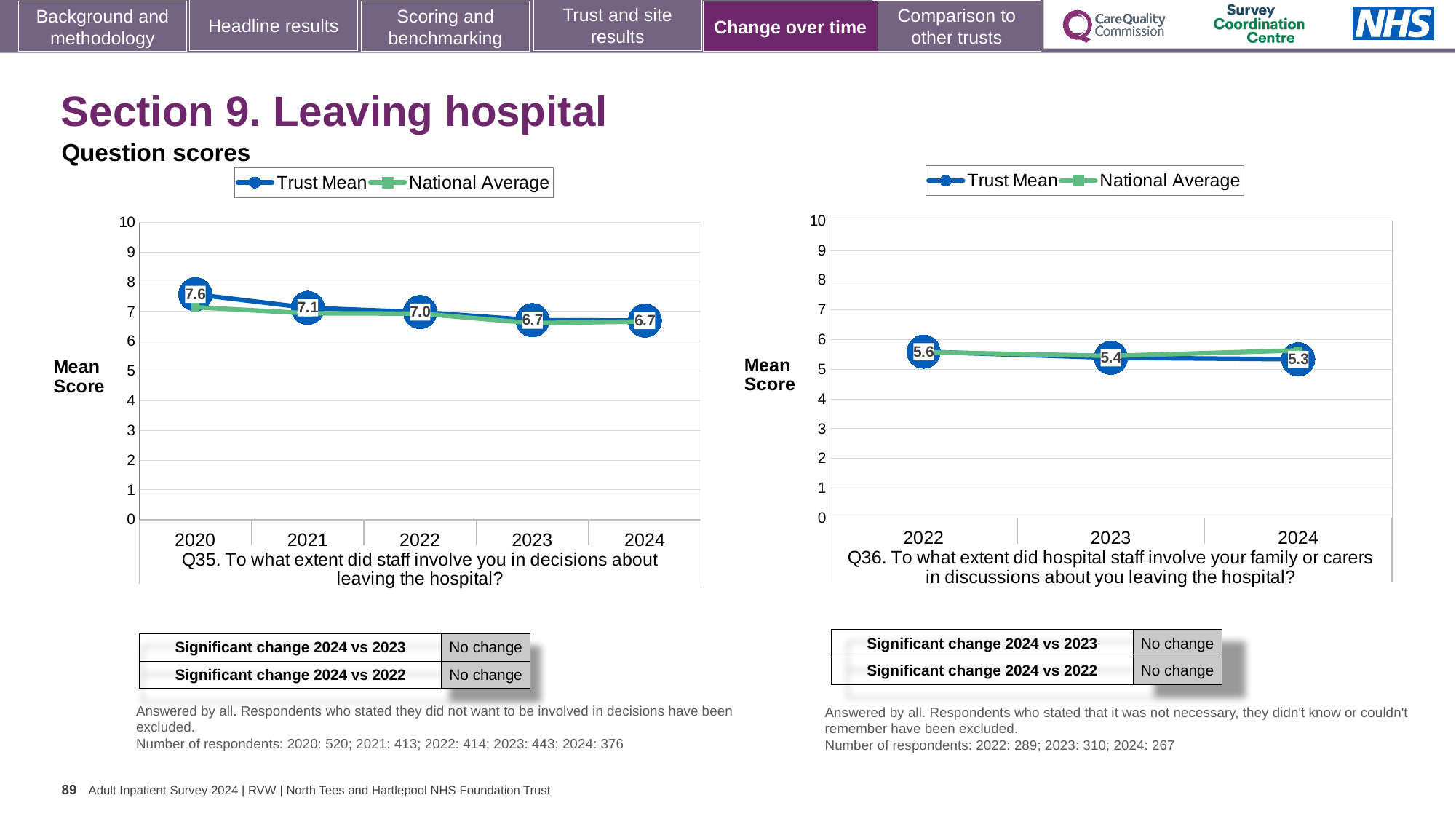
In the Q35 chart on the left, what is the difference between the Trust Mean scores for 2020 and 2024? 0.9 In the Q35 chart on the left, what is the Trust Mean score for 2020? 7.6 In the Q36 chart on the right, what is the difference between the Trust Mean scores for 2022 and 2024? 0.3 In the Q36 chart on the right, what is the Trust Mean score for 2024? 5.3 In the Q35 chart on the left, which year has the highest Trust Mean score? 2020 How many years are plotted on the x axis of the Q35 chart on the left? 5 In the Q35 chart on the left, what is the Trust Mean score for 2022? 7.0 In the Q36 chart on the right, which year has the lowest Trust Mean score? 2024 In the Q35 chart on the left, is the Trust Mean score for 2021 larger or smaller than the score for 2023? larger How many series does the legend of the Q36 chart on the right list? 2 What kind of chart is the Q35 chart on the left? line chart In the Q36 chart on the right, is the National Average value for 2024 greater or less than 5? greater